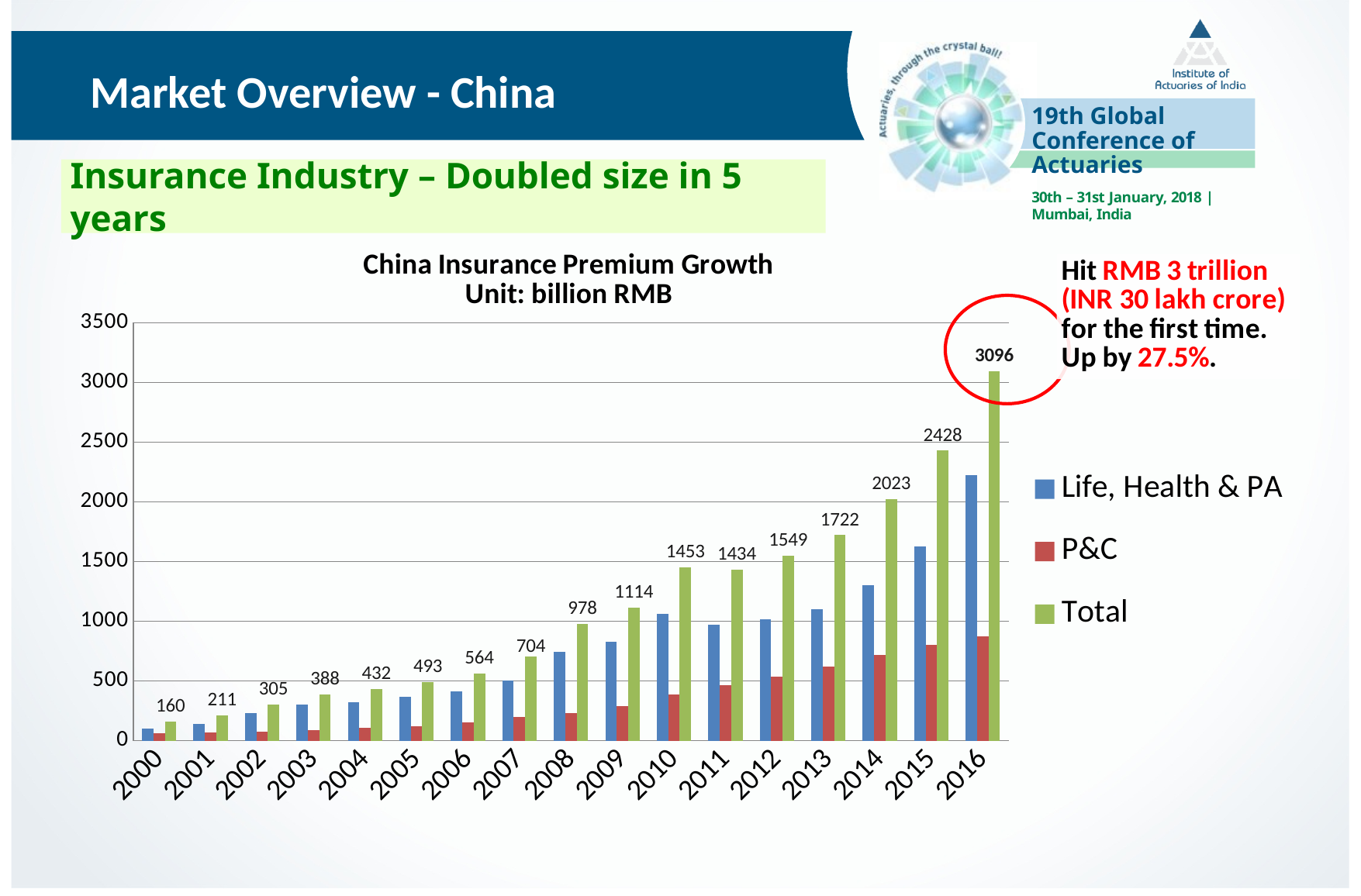
How many years are shown on the x axis? 17 What is the Total value for 2000? 160 What is the difference between the Total values for 2016 and 2015? 668 Which is larger, the Total value for 2010 or for 2011? 2010 What kind of chart is shown? bar chart What is the Total value for 2008? 978 Is the P&C value for 2015 greater or less than 1000? less What is the Total value for 2016? 3096 How many series does the legend list? 3 Which year has the lowest Total value? 2000 Is the Life, Health & PA value for 2016 greater or less than 2000? greater Which year has the highest Total value? 2016